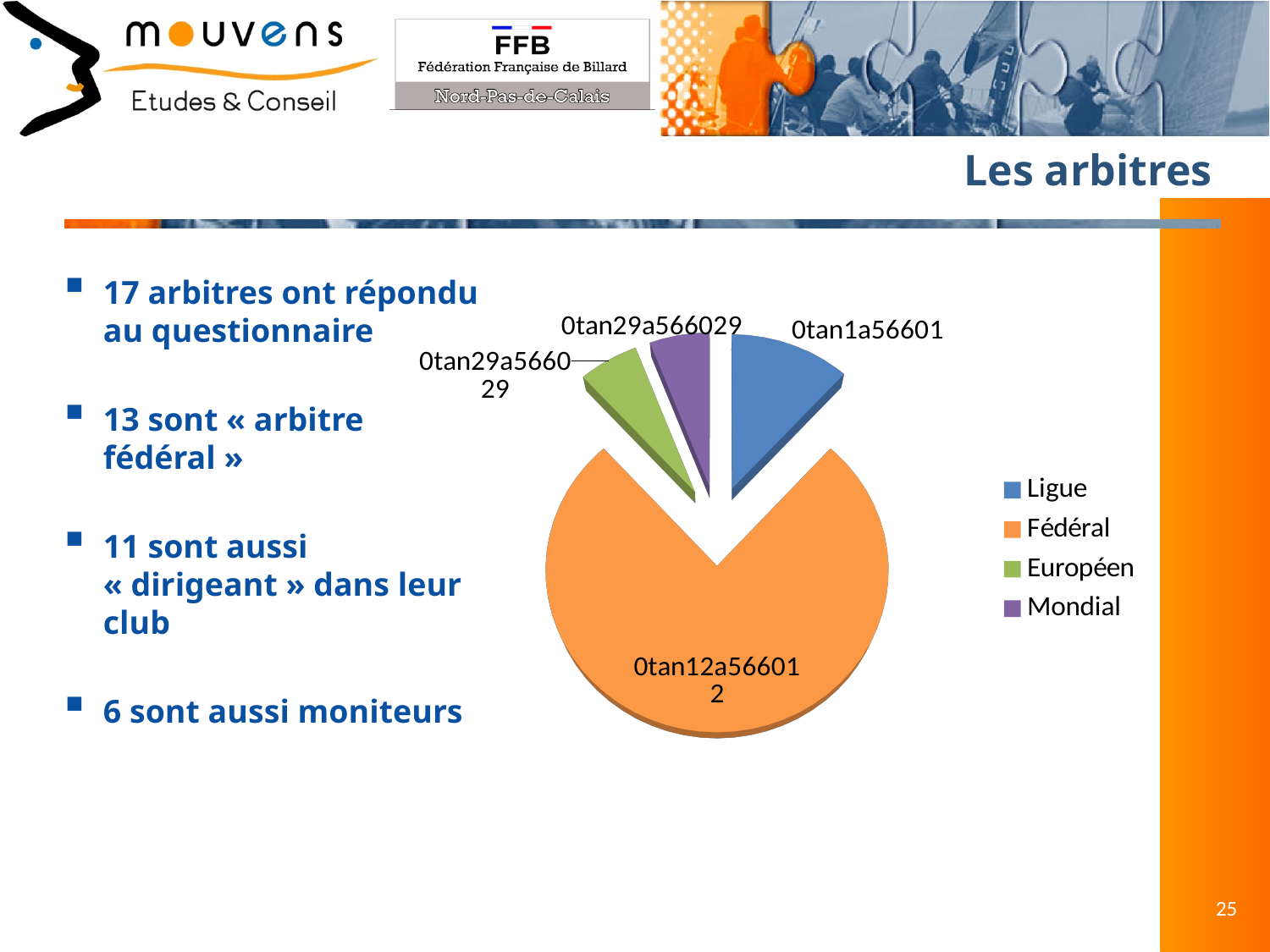
Which category has the largest slice in the pie chart? Fédéral Which slice is larger in the pie chart, Ligue or Mondial? Ligue How many entries does the legend of the pie chart list? 4 Which slice is larger in the pie chart, Fédéral or Ligue? Fédéral What kind of chart is shown on the slide? pie chart Which legend entry is listed first in the pie chart's legend? Ligue Which slice is larger in the pie chart, Ligue or Européen? Ligue How many slices does the pie chart have? 4 What colour is the Fédéral slice in the pie chart? orange